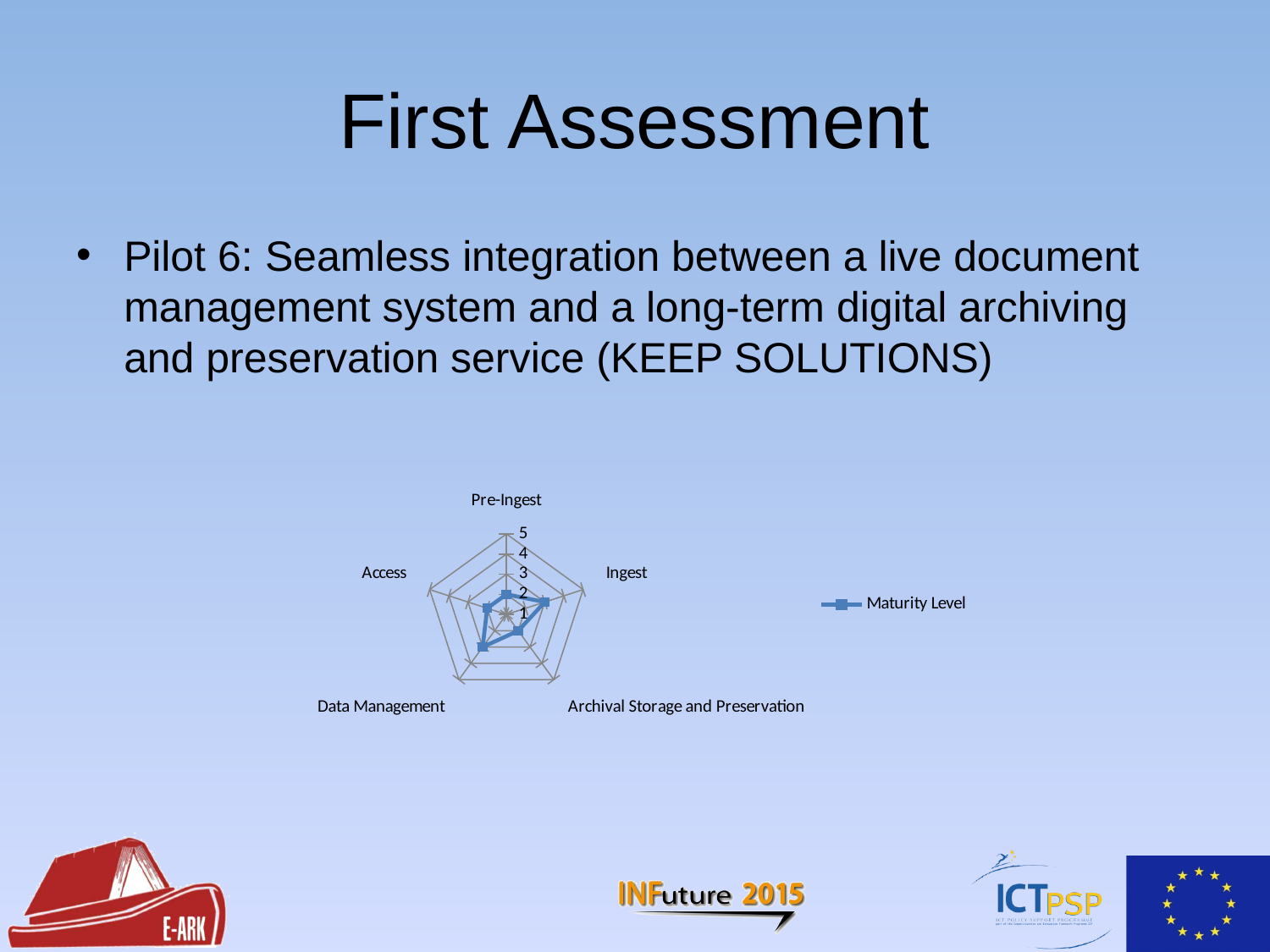
What is the highest value marked on the chart's scale? 5 Which has a higher Maturity Level, Data Management or Pre-Ingest? Data Management Which has a higher Maturity Level, Ingest or Access? Ingest Is the Maturity Level value for Access greater or less than 3? less Is the Maturity Level value for Archival Storage and Preservation greater or less than 3? less Is the Maturity Level value for Ingest greater or less than 4? less How many series does the chart legend list? 1 What is the name of the series shown in the chart legend? Maturity Level How many categories (axes) does the radar chart have? 5 What kind of chart is shown on the slide? Radar chart